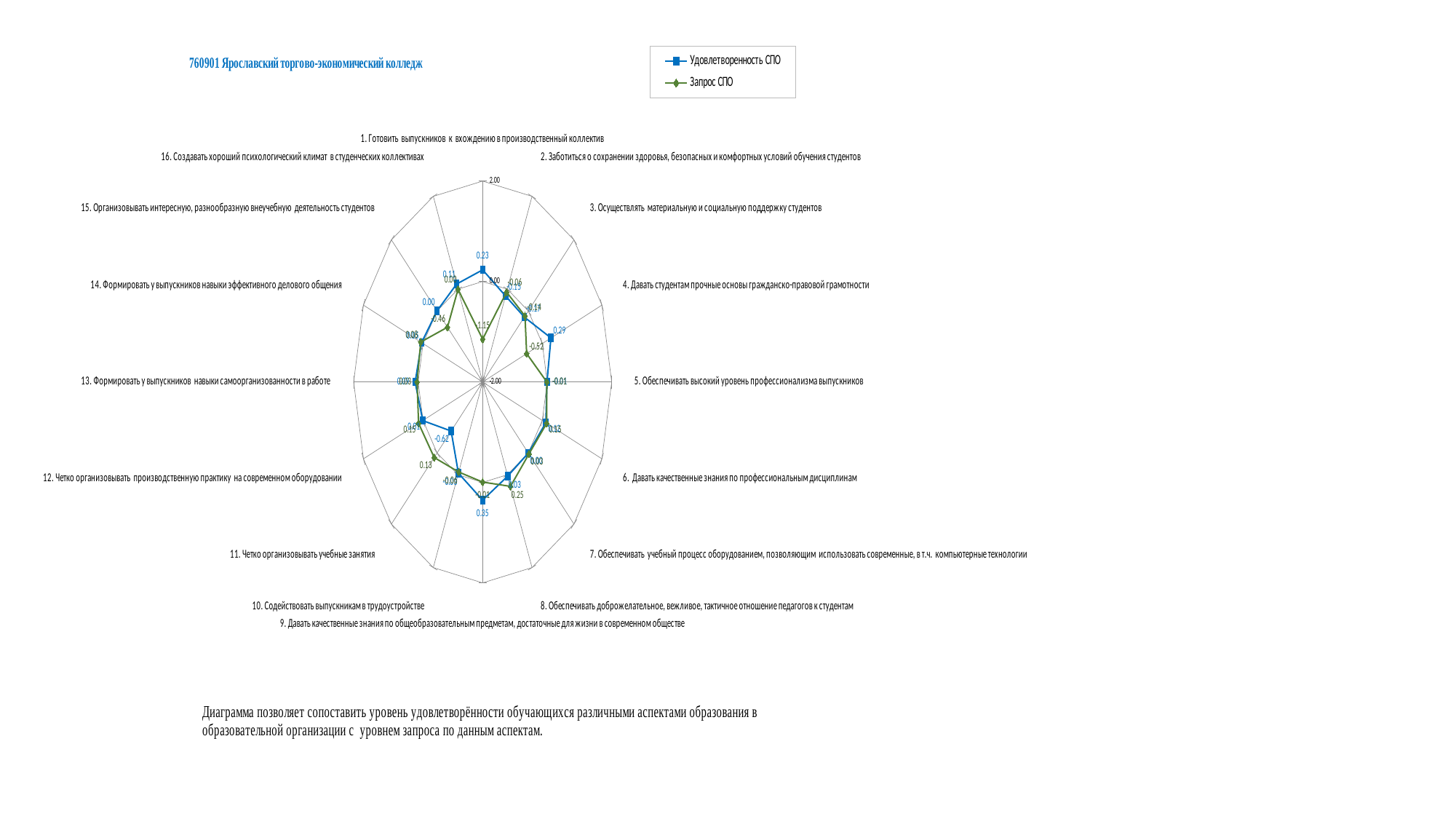
What is the difference between Удовлетворенность СПО and Запрос СПО for category 4? 0.81 What is the value of Удовлетворенность СПО for category 11 (Четко организовывать учебные занятия)? -0.62 What is the value of Удовлетворенность СПО for category 9 (Давать качественные знания по общеобразовательным предметам)? 0.35 What are the two series named in the legend? Удовлетворенность СПО and Запрос СПО What is the value of Удовлетворенность СПО for category 1 (Готовить выпускников к вхождению в производственный коллектив)? 0.23 What kind of chart is shown on the slide? Radar chart For category 4, which series has the larger value: Удовлетворенность СПО or Запрос СПО? Удовлетворенность СПО For which category is the Удовлетворенность СПО value the lowest? 11. Четко организовывать учебные занятия How many series does the legend list? 2 How many categories (axes) does the radar chart have? 16 What is the value of Запрос СПО for category 4 (Давать студентам прочные основы гражданско-правовой грамотности)? -0.52 What is the value of Удовлетворенность СПО for category 4 (Давать студентам прочные основы гражданско-правовой грамотности)? 0.29